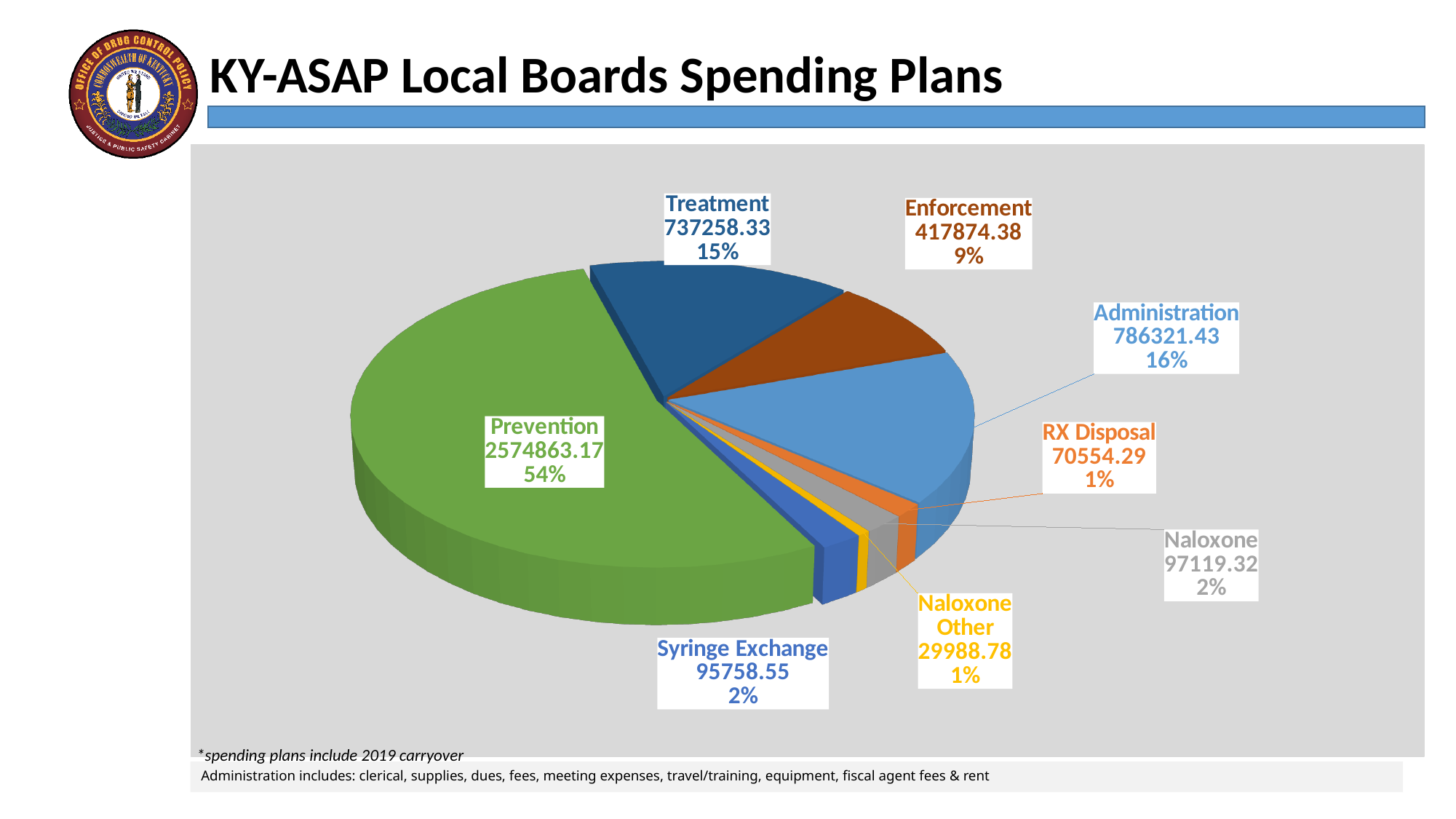
What is the difference between the Treatment and Enforcement values? 319383.95 Which category has the smallest value? Naloxone Other How many categories are shown in the pie chart? 8 What type of chart is shown on the slide? Pie chart Which category has the largest slice of the pie? Prevention What is the value shown for Prevention? 2574863.17 What is the title of the slide containing the chart? KY-ASAP Local Boards Spending Plans What is the value shown for Naloxone Other? 29988.78 What percentage share does Administration have? 16% What is the difference between the Administration and Treatment values? 49063.10 Which is larger, the value for Treatment or the value for Enforcement? Treatment What is the value shown for Enforcement? 417874.38